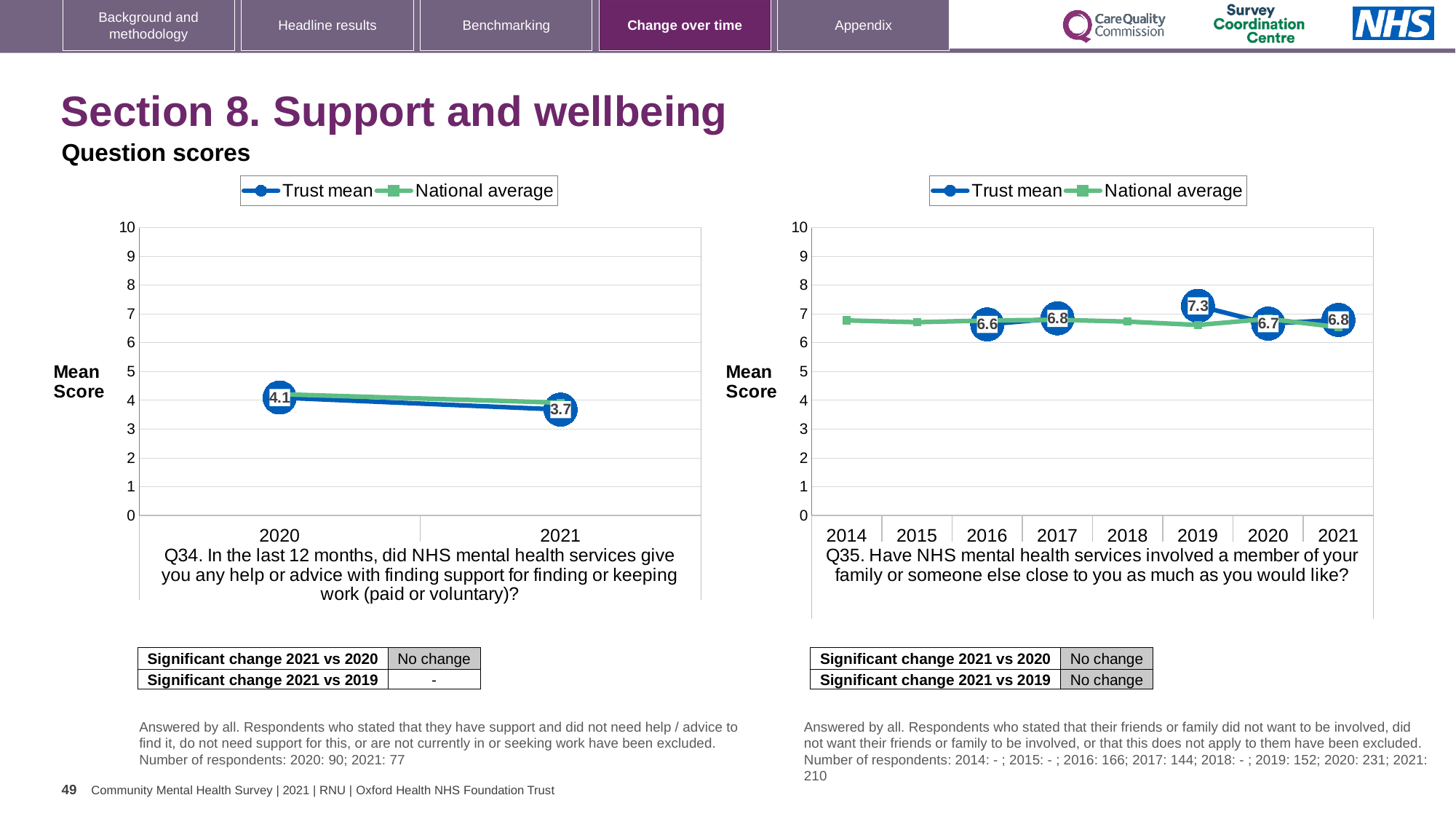
How many series does the legend of the Q35 chart on the right list? 2 In the Q35 chart on the right, is the Trust mean for 2019 greater or less than 7? greater In the Q34 chart on the left, by how much did the Trust mean fall from 2020 to 2021? 0.4 In the Q34 chart on the left, what is the Trust mean for 2020? 4.1 In the Q34 chart on the left, what is the Trust mean for 2021? 3.7 In the Q35 chart on the right, what is the Trust mean for 2016? 6.6 In the Q34 chart on the left, does the Trust mean rise or fall from 2020 to 2021? fall In the Q35 chart on the right, what is the Trust mean for 2019? 7.3 In the Q35 chart on the right, what is the difference between the Trust mean in 2019 and in 2020? 0.6 In the Q35 chart on the right, which year has the lowest labelled Trust mean? 2016 In the Q35 chart on the right, which year has the highest Trust mean? 2019 What kind of chart is the Q34 chart on the left? line chart